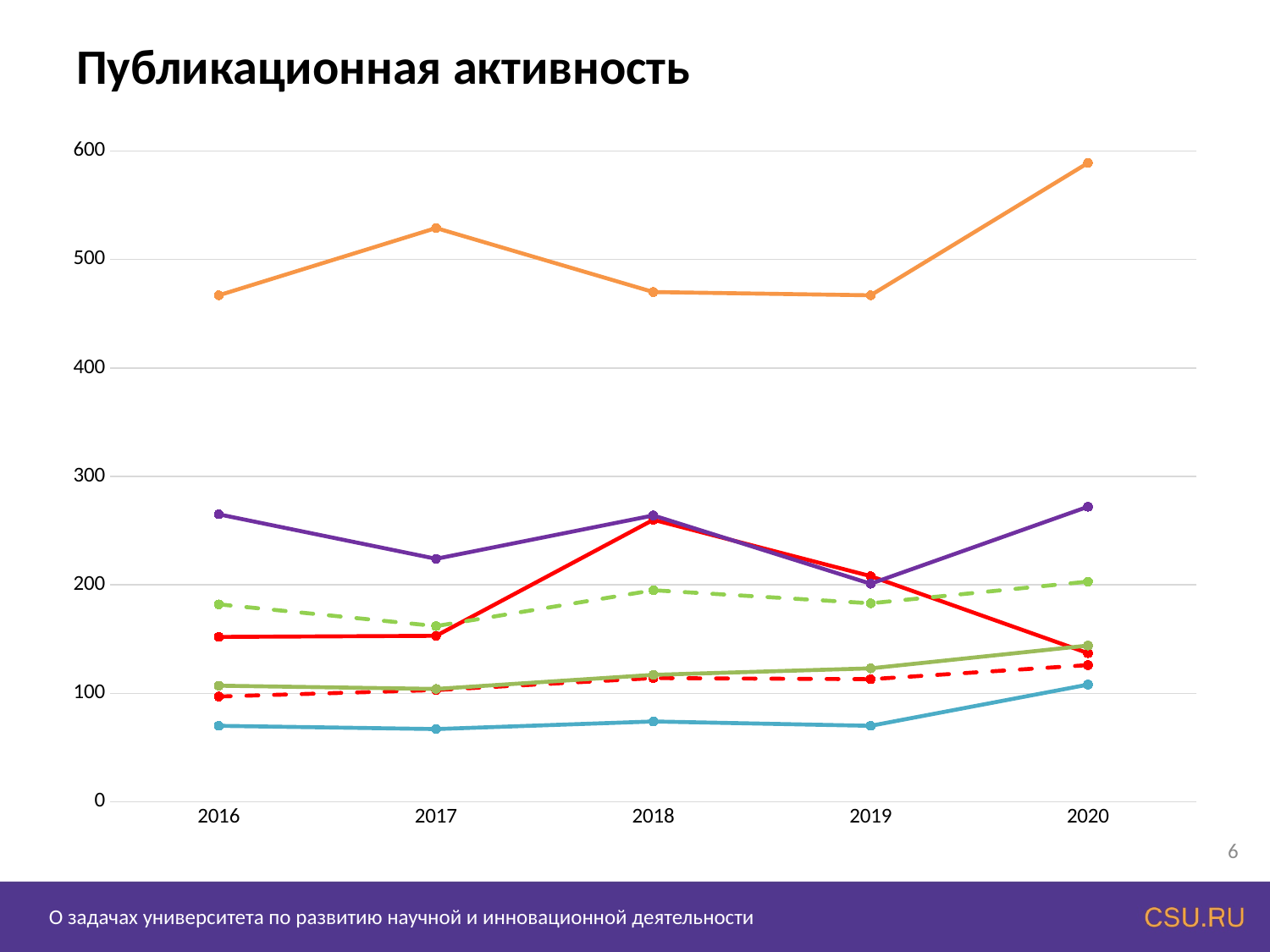
How many lines are plotted on the chart? 7 What kind of chart is shown on the slide? line chart In which year does the orange line reach its highest value? 2020 What is the title of the chart? Публикационная активность Is the value of the orange line in 2016 greater or less than 500? less Which line has the highest values across all years? the orange line Is the value of the blue line in 2016 greater or less than 100? less Which is larger for the orange line: the value in 2017 or the value in 2018? 2017 How many years are shown on the x axis? 5 Is the value of the solid red line in 2018 greater or less than 200? greater Does the orange line rise or fall from 2019 to 2020? rise